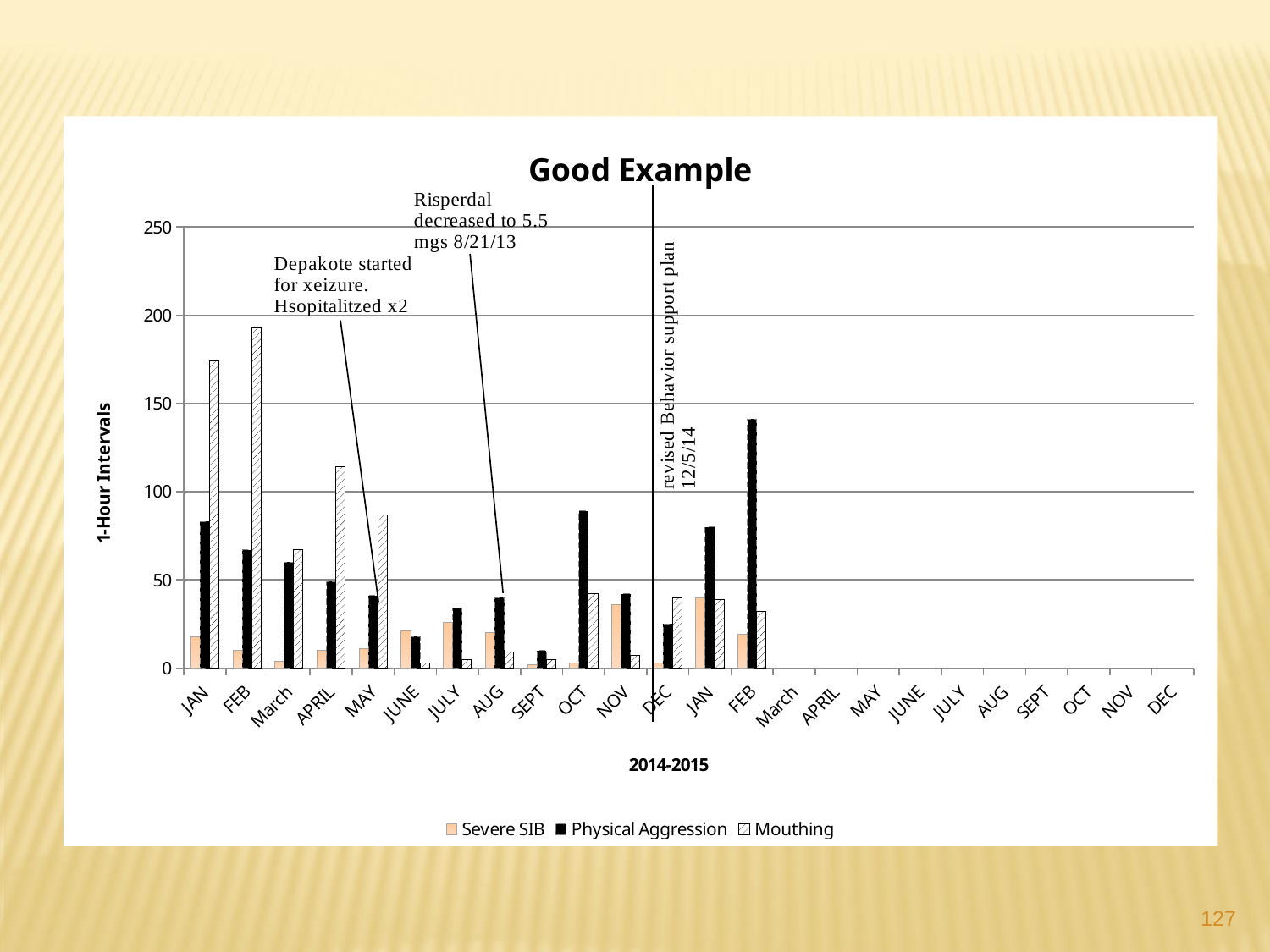
In OCT, which is larger: Physical Aggression or Mouthing? Physical Aggression Is the Physical Aggression value for OCT greater or less than 50? greater In the first JAN, which is larger: Mouthing or Physical Aggression? Mouthing How many month categories are labelled along the x axis? 24 In which month is the Mouthing bar highest? FEB (first year) In which month is the Physical Aggression bar highest? FEB (second year, after the vertical line) Is the Mouthing value for the first JAN greater or less than 150? greater Is the Mouthing value for APRIL greater or less than 100? greater How many series does the legend list? 3 What are the three series named in the legend? Severe SIB, Physical Aggression, Mouthing What is the title of the vertical axis? 1-Hour Intervals What type of chart is shown on the slide? Bar chart